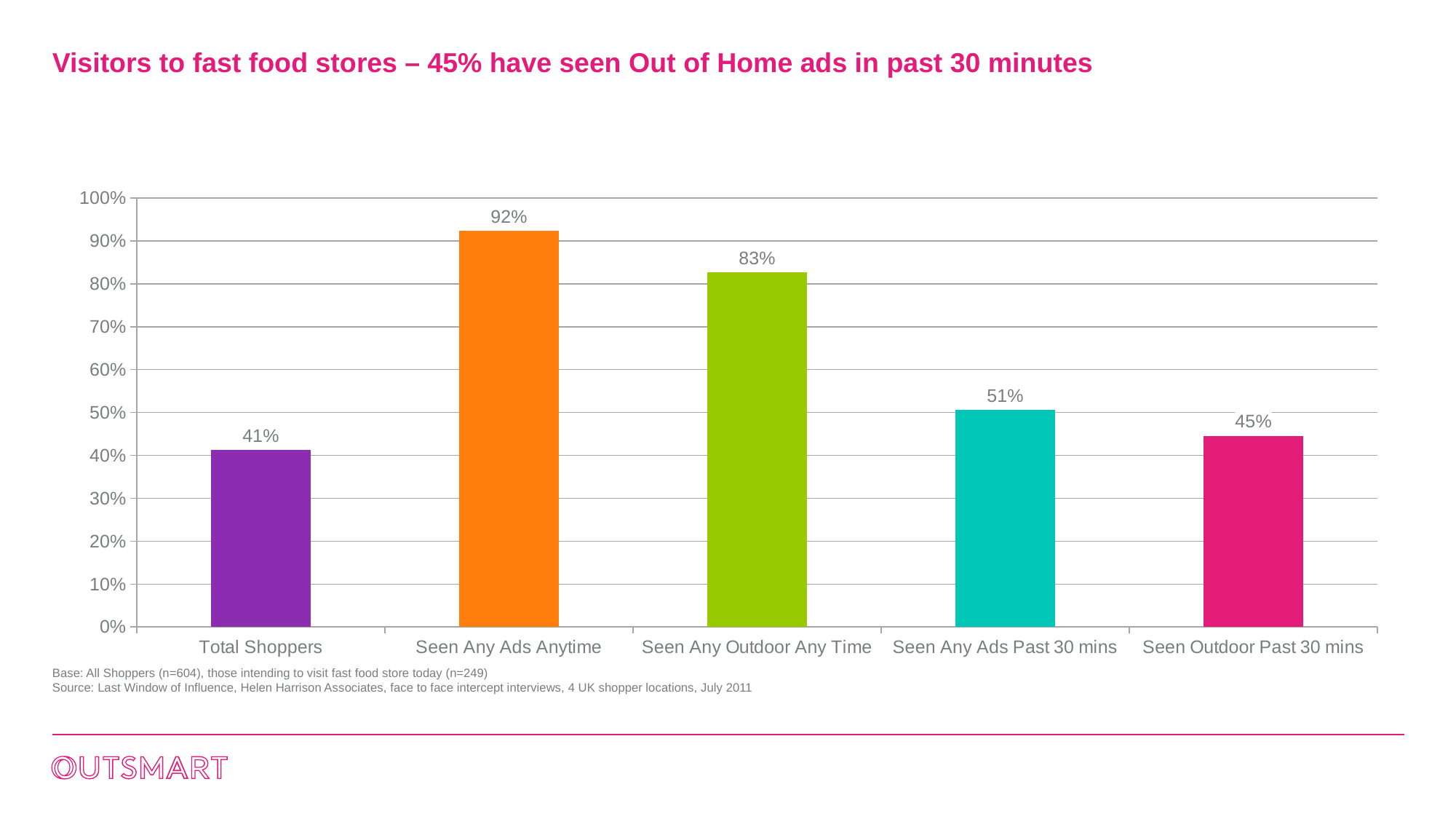
Which category has the highest value? Seen Any Ads Anytime What kind of chart is shown on the slide? Bar chart Which category has the lowest value? Total Shoppers What is the value for Seen Any Ads Anytime? 92% What is the value for Seen Any Outdoor Any Time? 83% What is the value for Seen Outdoor Past 30 mins? 45% How many categories are shown on the chart? 5 Which is larger, Seen Any Ads Past 30 mins or Seen Outdoor Past 30 mins? Seen Any Ads Past 30 mins What colour is the bar for Seen Any Ads Anytime? Orange What is the difference between Seen Any Ads Anytime and Seen Any Outdoor Any Time? 9% What is the value for Total Shoppers? 41% What is the value for Seen Any Ads Past 30 mins? 51%